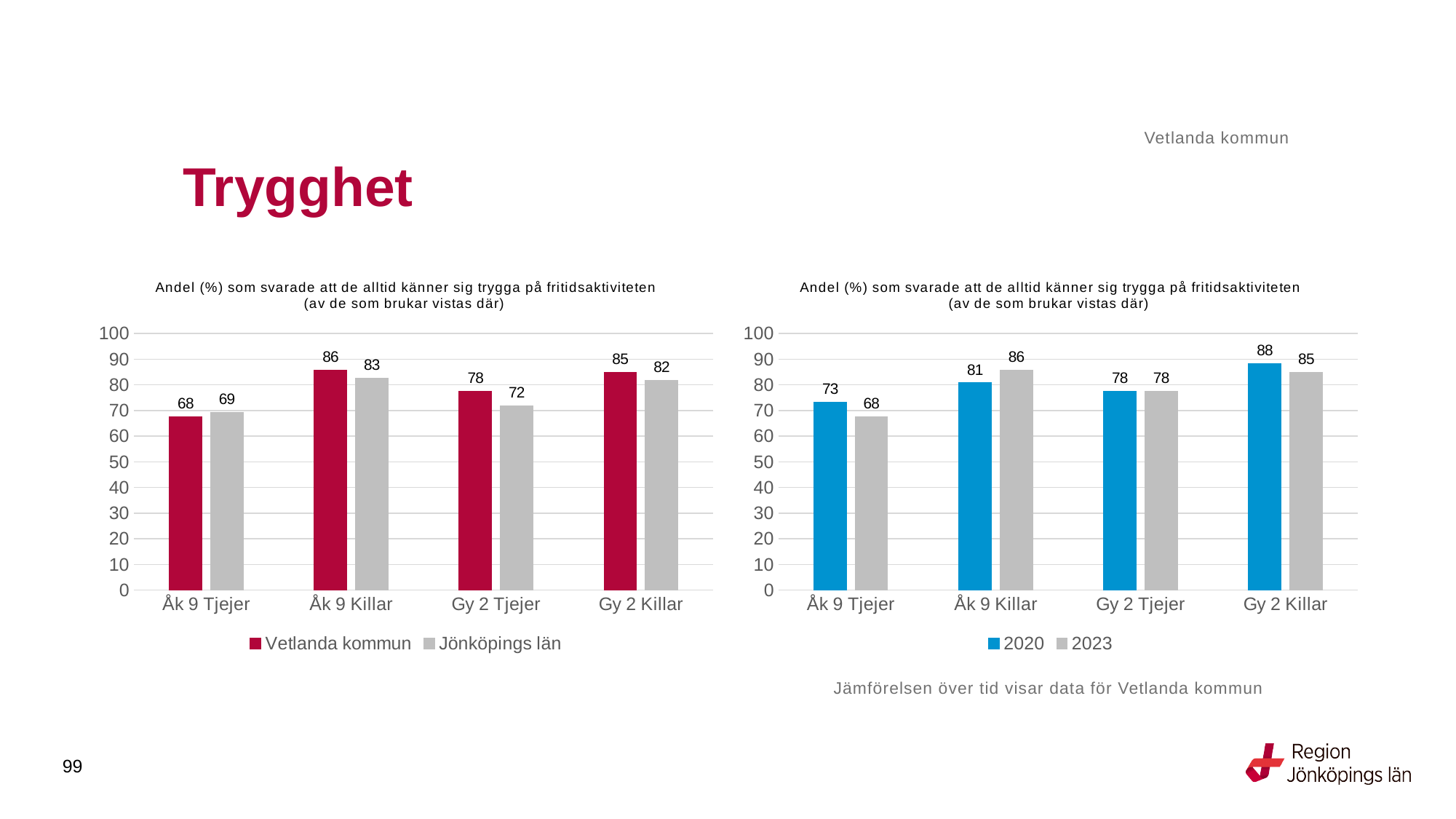
In the left chart, which category has the highest value for Vetlanda kommun? Åk 9 Killar How many series does the legend of the right chart list? 2 In the left chart, which category has the lowest value for Jönköpings län? Åk 9 Tjejer In the left chart, what is the difference between Vetlanda kommun and Jönköpings län for Gy 2 Tjejer? 6 How many categories are shown on the x axis of the left chart? 4 In the left chart, what is the value for Vetlanda kommun for Åk 9 Killar? 86 What kind of chart is the left chart? Bar chart In the right chart, what is the difference between 2020 and 2023 for Åk 9 Tjejer? 5 In the right chart, what is the value for 2020 for Gy 2 Killar? 88 In the left chart, what is the value for Jönköpings län for Gy 2 Tjejer? 72 In the right chart, which is larger for Åk 9 Killar, 2020 or 2023? 2023 In the right chart, what is the value for 2023 for Åk 9 Tjejer? 68